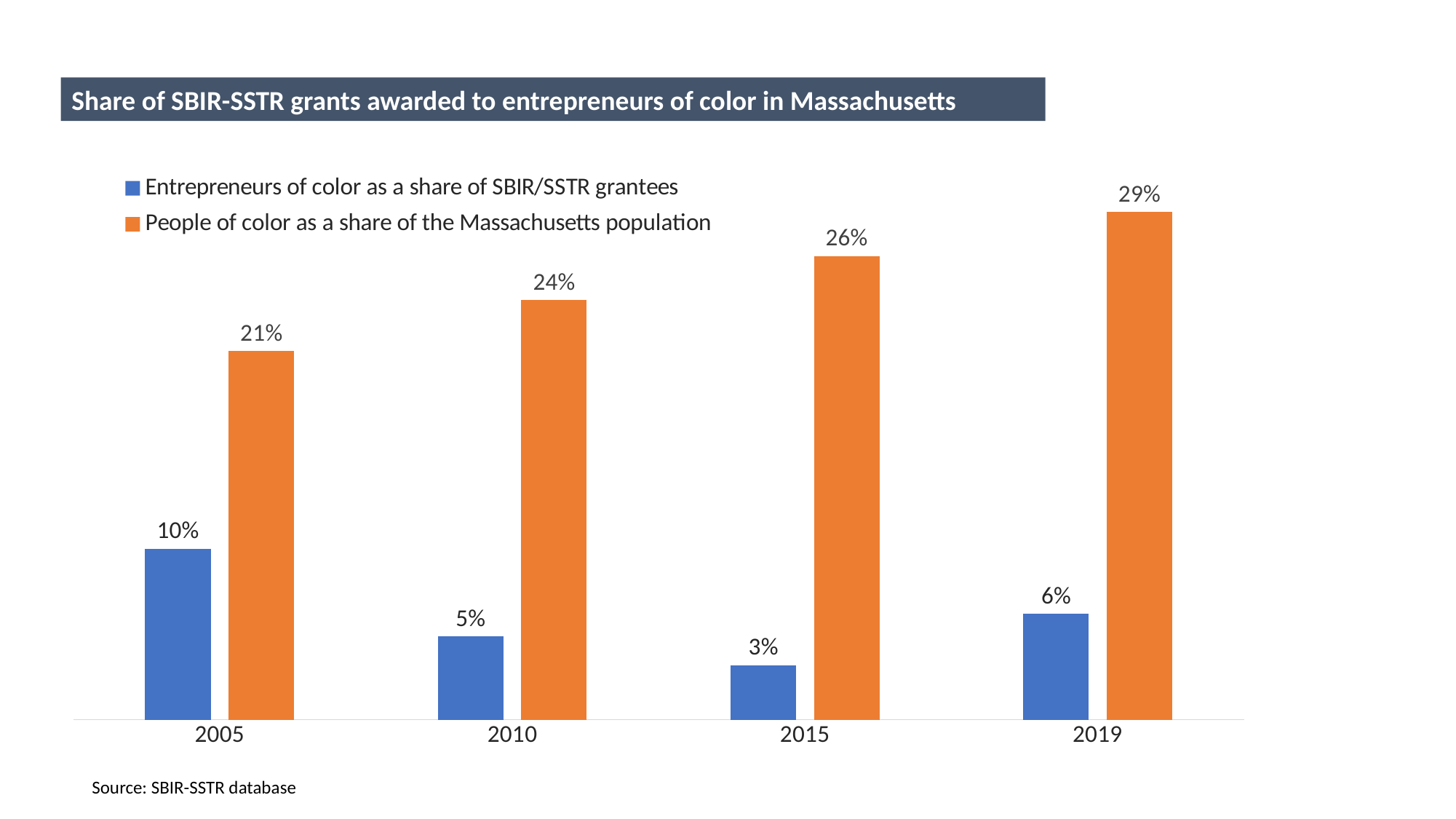
Does the share of people of color in the Massachusetts population rise or fall from 2005 to 2019? Rise In which year was the share of entrepreneurs of color among SBIR/SSTR grantees highest? 2005 What kind of chart is shown on the slide? Bar chart Which is larger in 2010: the share of entrepreneurs of color among grantees or the share of people of color in the Massachusetts population? People of color as a share of the Massachusetts population How many years are shown on the x axis? 4 What share of SBIR/SSTR grantees were entrepreneurs of color in 2015? 3% What share of SBIR/SSTR grantees were entrepreneurs of color in 2005? 10% In which year was the share of entrepreneurs of color among SBIR/SSTR grantees lowest? 2015 What colour are the bars for people of color as a share of the Massachusetts population? Orange What was the share of people of color in the Massachusetts population in 2019? 29% How many series does the legend list? 2 What is the difference between the share of people of color in the Massachusetts population and the share of entrepreneurs of color among grantees in 2019? 23%